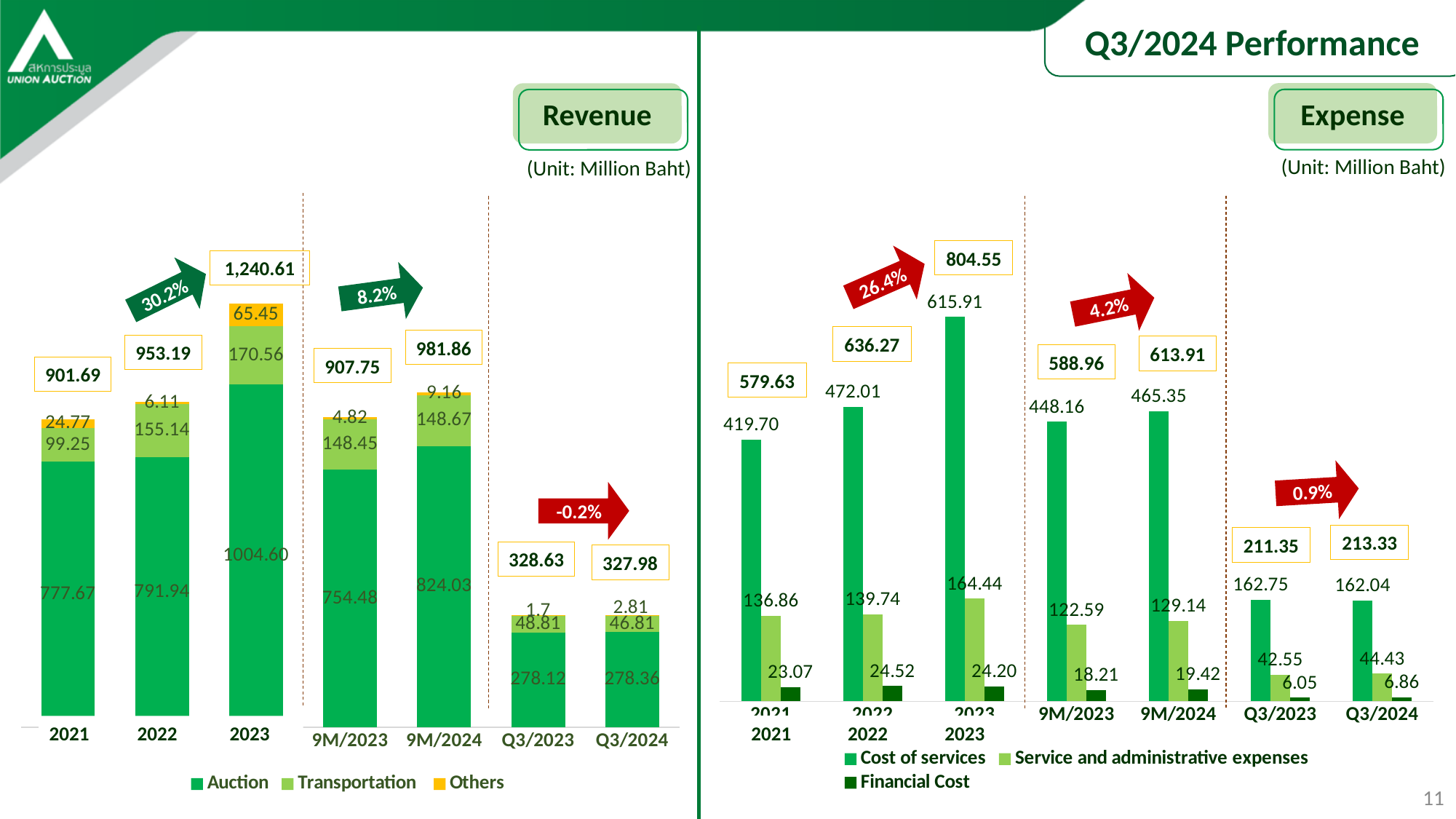
On the Revenue chart, what is the Auction value for 2023? 1004.60 On the Revenue chart, what is the difference between the Transportation values for 2023 and 2022? 15.42 On the Revenue chart, which of the years 2021, 2022 and 2023 has the highest total revenue? 2023 How many series does the legend of the Revenue chart list? 3 On the Expense chart, is the Service and administrative expenses value larger in 2021 or 2022? 2022 On the Expense chart, what is the difference between the Cost of services values for 2023 and 2022? 143.90 How many periods are shown on the x axis of the Expense chart? 7 On the Revenue chart, what is the total revenue shown for 2023? 1,240.61 On the Expense chart, which period has the lowest Financial Cost? Q3/2023 On the Expense chart, what is the Cost of services value for 9M/2024? 465.35 What kind of chart is the Revenue chart? Stacked bar chart On the Revenue chart, what is the Others value for 2021? 24.77